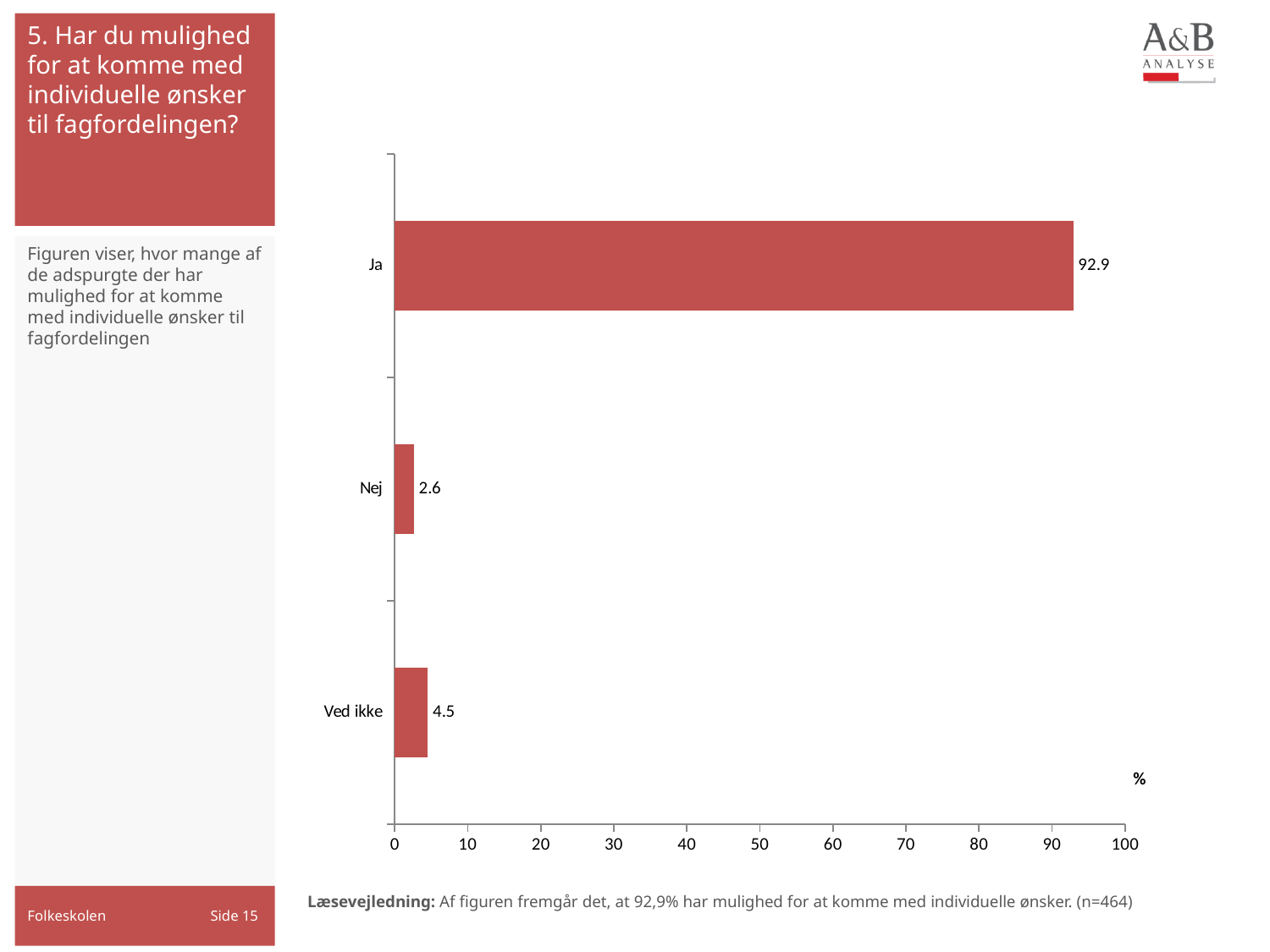
What unit label is shown at the end of the horizontal axis? % What is the value for "Ja"? 92.9 What kind of chart is shown on the slide? bar chart What is the difference between the values for "Ved ikke" and "Nej"? 1.9 Is the value for "Ja" greater or less than 90? greater Which category has the highest value? Ja Which category has the lowest value? Nej What is the value for "Nej"? 2.6 What is the difference between the values for "Ja" and "Nej"? 90.3 What is the value for "Ved ikke"? 4.5 How many categories are shown in the chart? 3 Which is larger, the value for "Ved ikke" or the value for "Nej"? Ved ikke